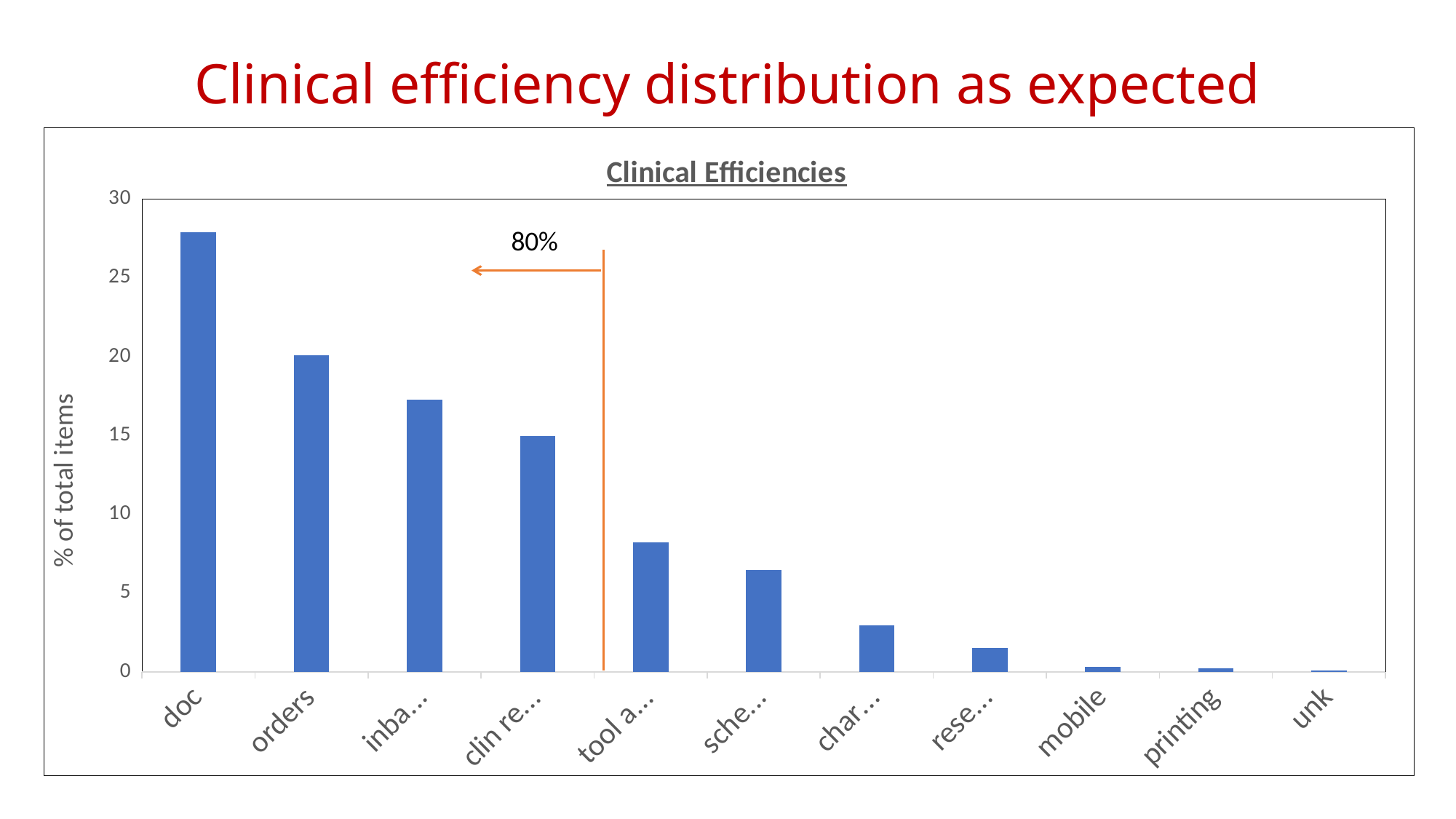
Is the value for the fifth bar from the left (tool a…) greater or less than 10? less Which is larger, the value for orders or the value for mobile? orders What kind of chart is shown on the slide? bar chart Do the bar values rise or fall moving from left to right along the x axis? fall Is the value for orders greater or less than 25? less How many categories are plotted on the x axis of the Clinical Efficiencies chart? 11 Is the value for orders greater or less than 15? greater What is the title of the y axis? % of total items Which category has the highest value in the Clinical Efficiencies chart? doc Which is larger, the value for doc or the value for orders? doc